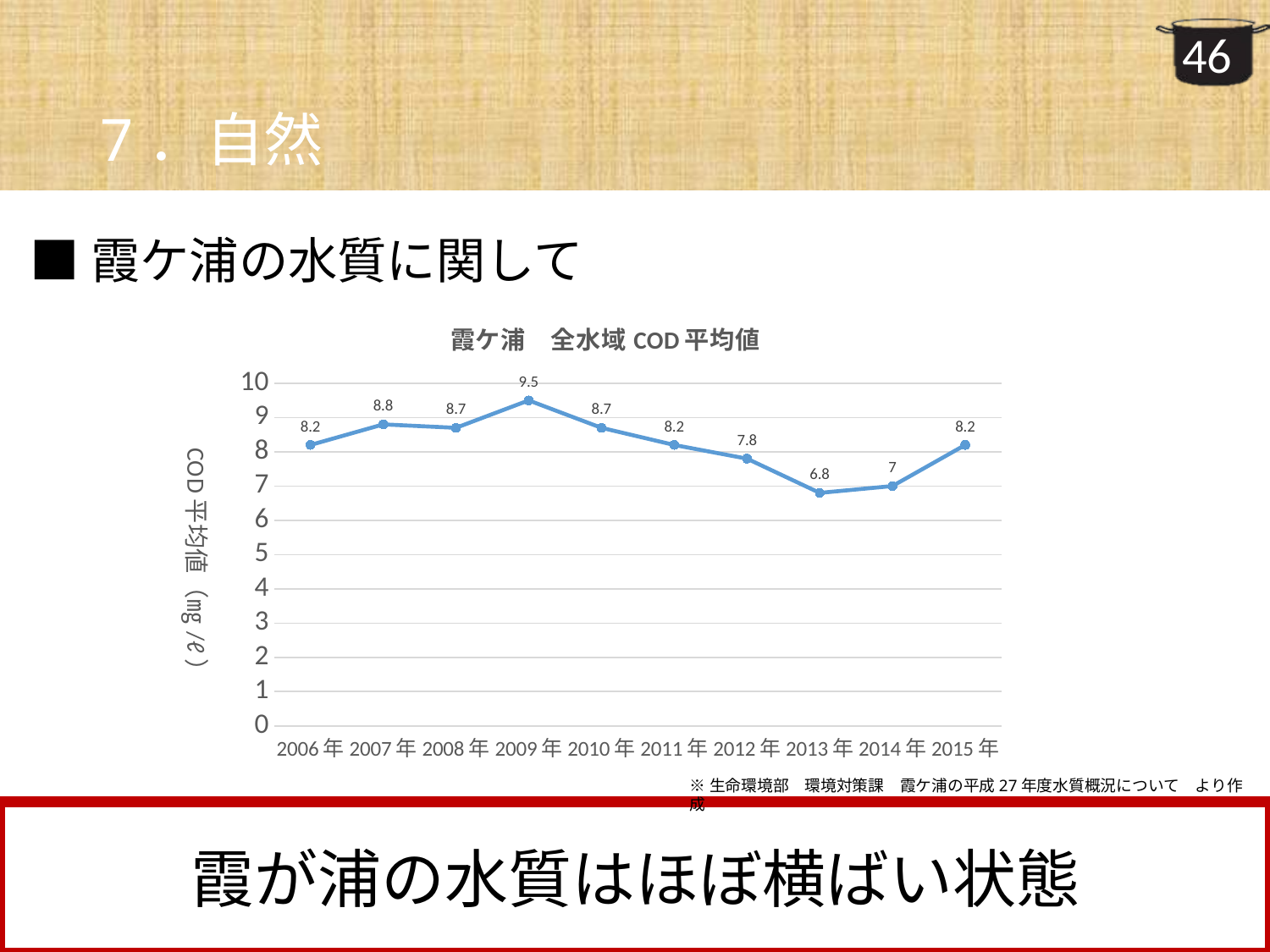
What is the COD average value for 2013年? 6.8 Which year has the lowest COD average value? 2013年 What is the COD average value for 2009年? 9.5 Is the COD average value for 2014年 greater or less than 8? less How many years are plotted on the chart? 10 What is the title of the chart? 霞ケ浦 全水域COD平均値 Which year has the highest COD average value? 2009年 Which year has a higher COD average value, 2007年 or 2012年? 2007年 Do the COD average values rise or fall from 2009年 to 2013年? fall What kind of chart is shown on the slide? line chart What is the COD average value for 2015年? 8.2 What is the difference between the COD average values for 2009年 and 2013年? 2.7